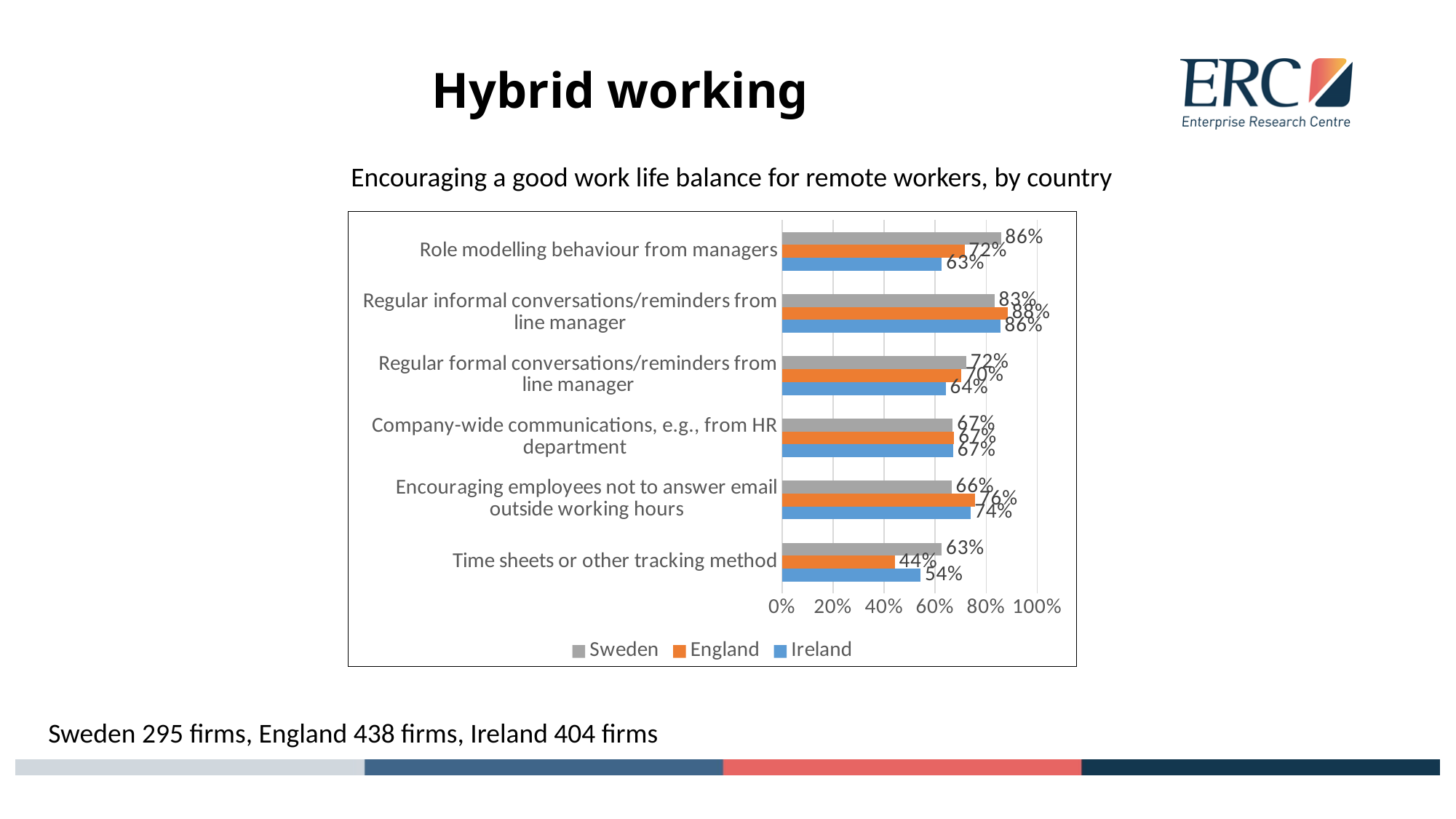
What kind of chart is shown on the slide? Bar chart How many categories are shown on the chart? 6 How many series does the legend list? 3 Which category has the lowest value for England? Time sheets or other tracking method For "Time sheets or other tracking method", how much higher is the Sweden value than the England value? 19 percentage points What is the value for England for "Time sheets or other tracking method"? 44% What is the value for Ireland for "Time sheets or other tracking method"? 54% What is the value for Sweden for "Role modelling behaviour from managers"? 86% What is the value for Ireland for "Role modelling behaviour from managers"? 63% Is the England value for "Time sheets or other tracking method" greater or less than 60%? less For "Role modelling behaviour from managers", which is larger: the Sweden value or the Ireland value? Sweden Which category has the highest value for Sweden? Role modelling behaviour from managers